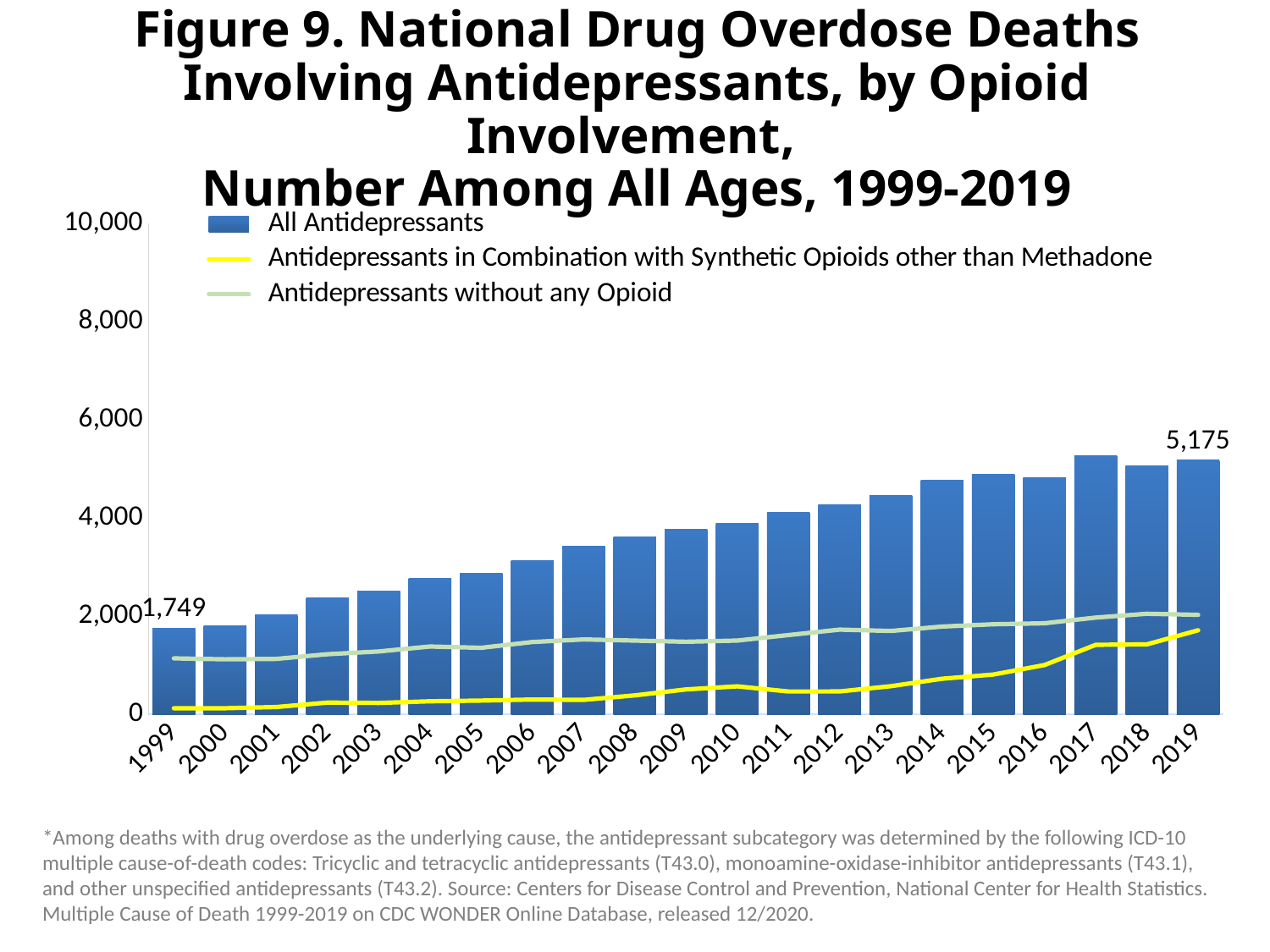
Is the All Antidepressants value for 2005 greater or less than 2,000? greater How many years are shown on the x axis? 21 What is the difference between the All Antidepressants values for 2019 and 1999? 3,426 Which year has the larger All Antidepressants value, 1999 or 2019? 2019 What is the value for All Antidepressants in 1999? 1,749 Is the All Antidepressants value for 2014 greater or less than 4,000? greater How many series does the legend list? 3 Which series is higher in 2019, Antidepressants without any Opioid or Antidepressants in Combination with Synthetic Opioids other than Methadone? Antidepressants without any Opioid Is the All Antidepressants value for 2010 greater or less than 4,000? less What is the value for All Antidepressants in 2019? 5,175 Do the All Antidepressants values generally rise or fall from 1999 to 2019? rise What colour is used for the All Antidepressants series? Blue